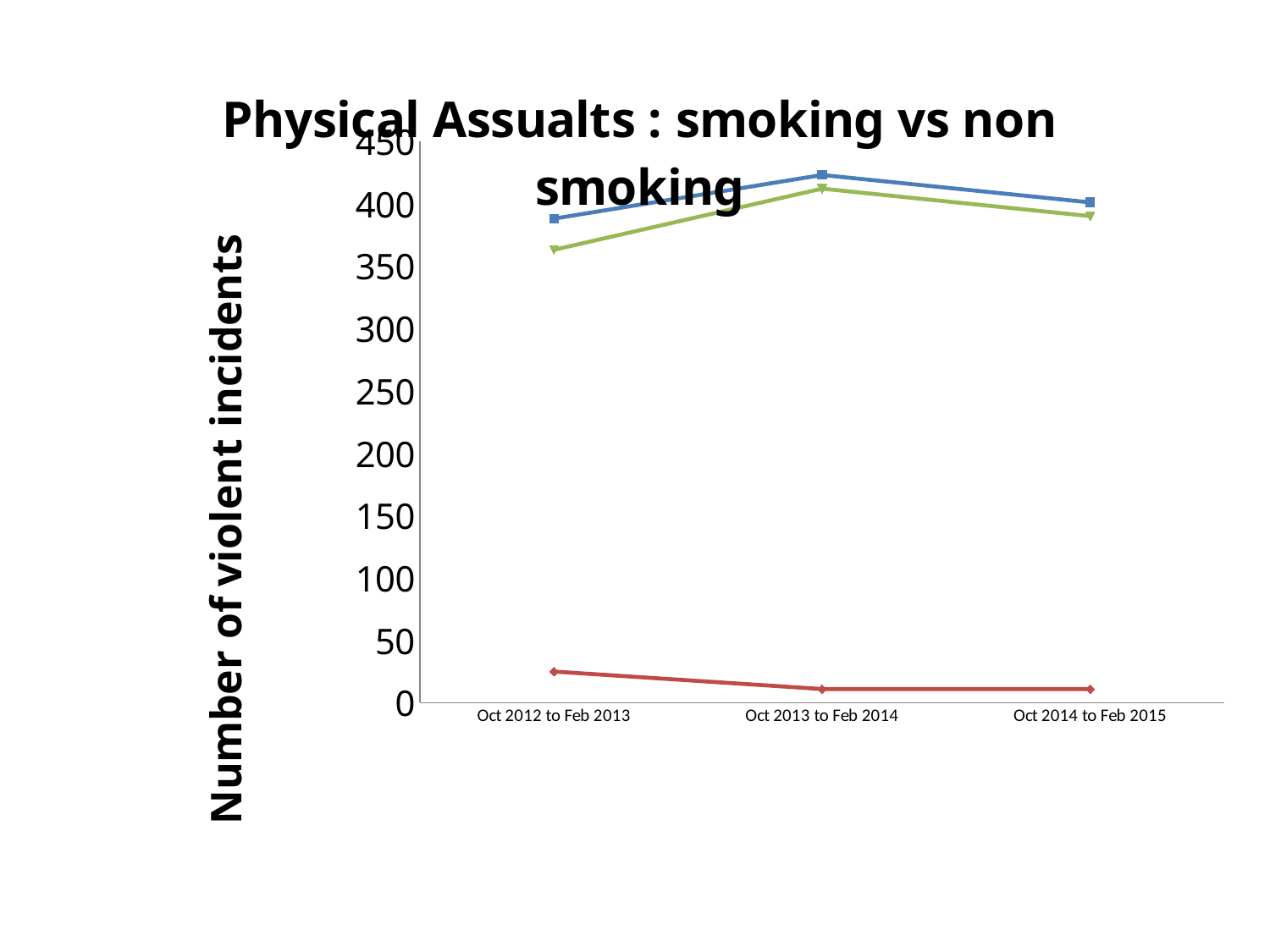
Is the value of the green line for Oct 2013 to Feb 2014 greater or less than 350? greater Is the value of the blue line for Oct 2013 to Feb 2014 greater or less than 400? greater How many time periods are shown along the x axis? 3 Is the value of the blue line for Oct 2012 to Feb 2013 greater or less than 350? greater What is the title of the chart? Physical Assualts : smoking vs non smoking What is the label on the vertical axis? Number of violent incidents Does the red line rise or fall from Oct 2012 to Feb 2013 to Oct 2013 to Feb 2014? fall In which period does the blue line reach its highest value? Oct 2013 to Feb 2014 What kind of chart is shown on the slide? line chart For Oct 2012 to Feb 2013, which line has the larger value, the blue line or the green line? blue line